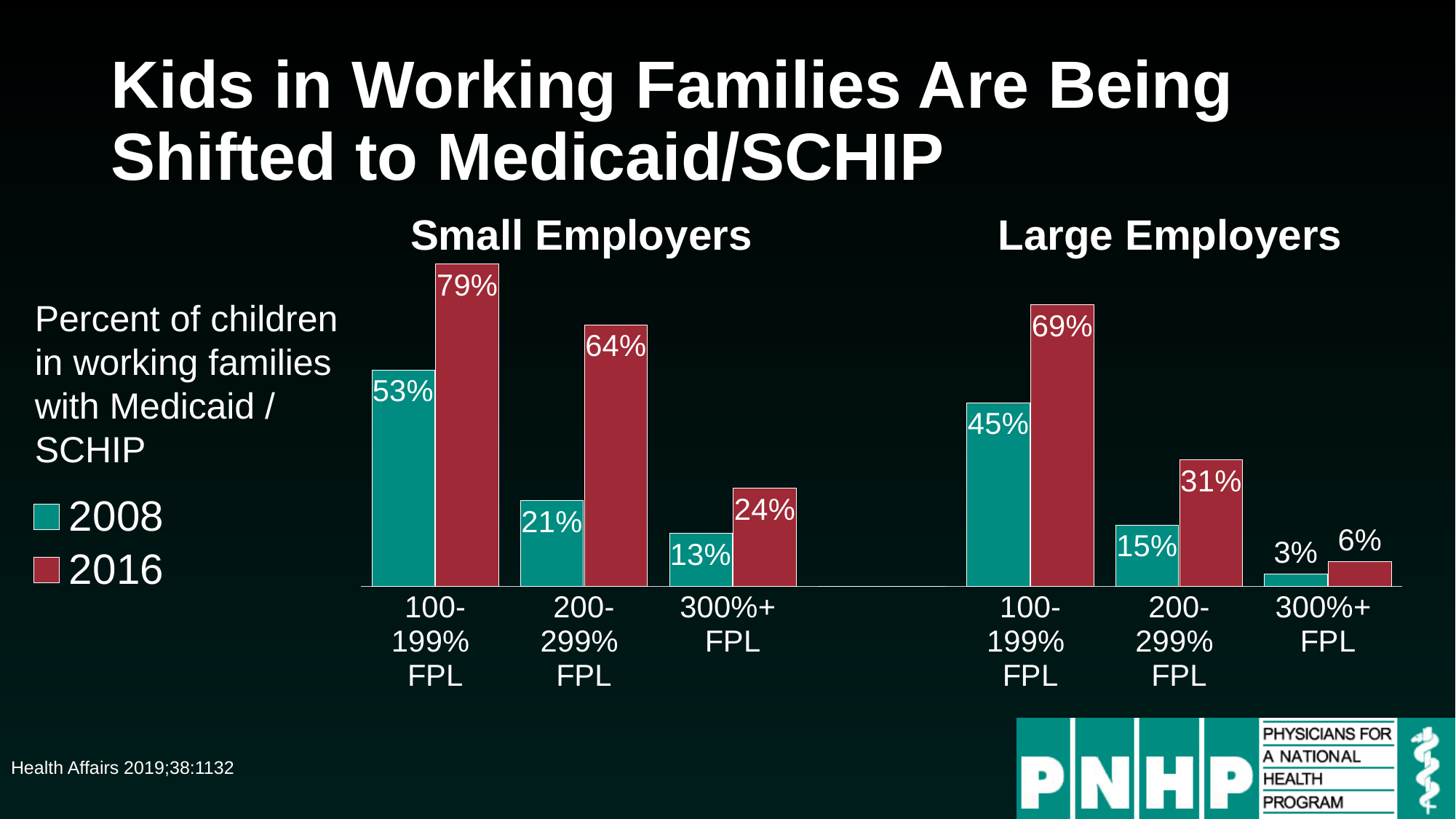
What percent of children in working families with small employers at 100-199% FPL had Medicaid/SCHIP in 2016? 79% What is the 2016 value for large employers at 300%+ FPL? 6% What kind of chart is shown on the slide? Bar chart What is the 2008 value for large employers at 200-299% FPL? 15% Which bar is the lowest on the whole chart? 2008, large employers, 300%+ FPL (3%) What is the difference between the 2016 and 2008 values for small employers at 200-299% FPL? 43 percentage points Within the large employers group, do the 2016 values rise or fall as income level increases from 100-199% FPL to 300%+ FPL? Fall Which year does the red series in the legend represent? 2016 What is the difference between the 2016 values for small and large employers at 100-199% FPL? 10 percentage points Which income group has the highest 2016 value among small employers? 100-199% FPL How many series does the legend list? 2 Which is larger: the 2008 value for small employers at 100-199% FPL or the 2016 value for large employers at 200-299% FPL? 2008 small employers at 100-199% FPL (53%)